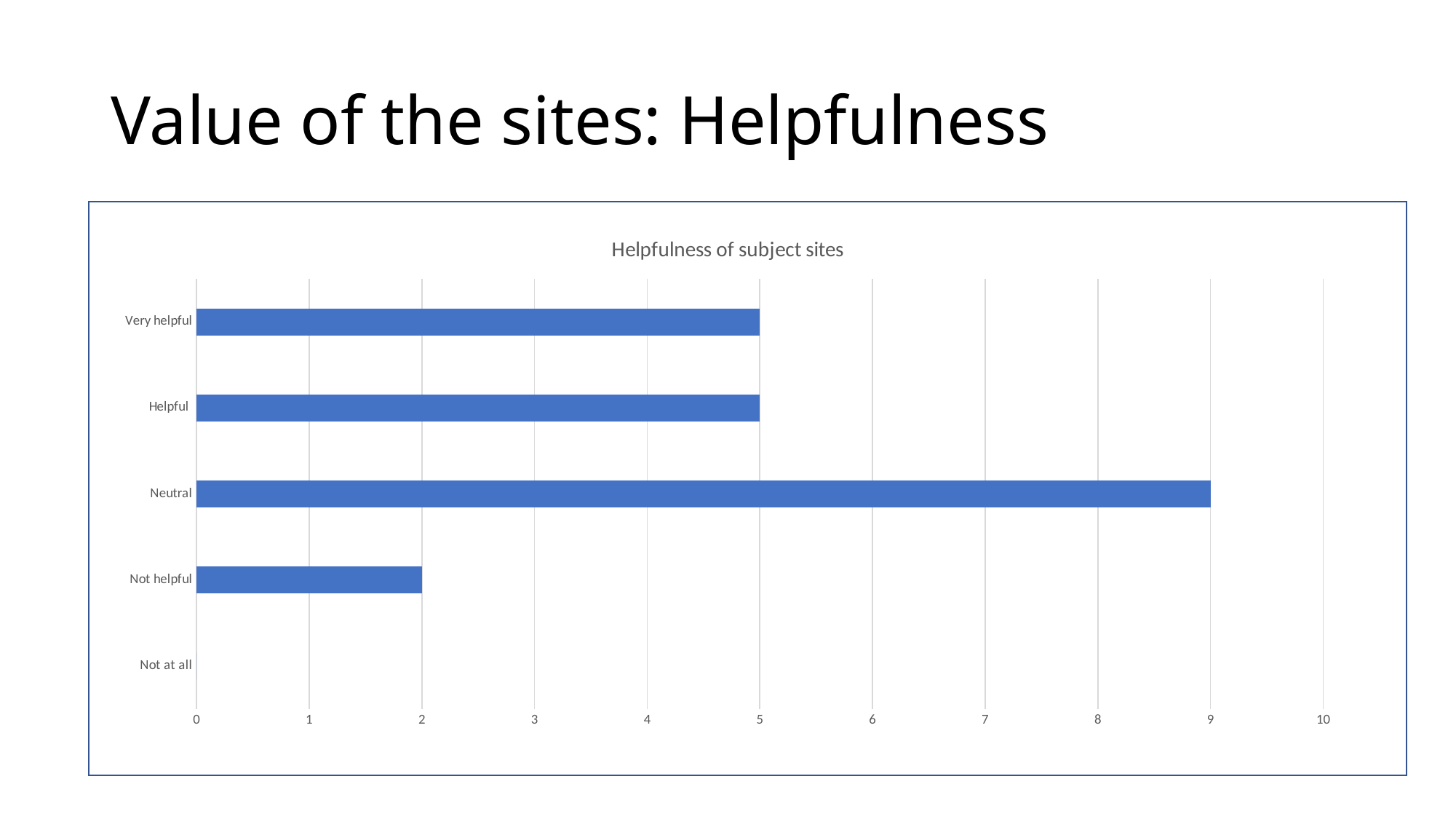
How many categories are shown on the chart? 5 Which category has the highest value? Neutral What is the difference between the values for Neutral and Helpful? 4 Which category has the lowest value? Not at all What type of chart is shown on the slide? Bar chart What is the value for Neutral? 9 Is the value for Neutral greater or less than 8? greater What is the value for Not helpful? 2 Which is larger, the value for Helpful or the value for Not helpful? Helpful What is the value for Not at all? 0 What is the title of the chart? Helpfulness of subject sites What is the value for Very helpful? 5